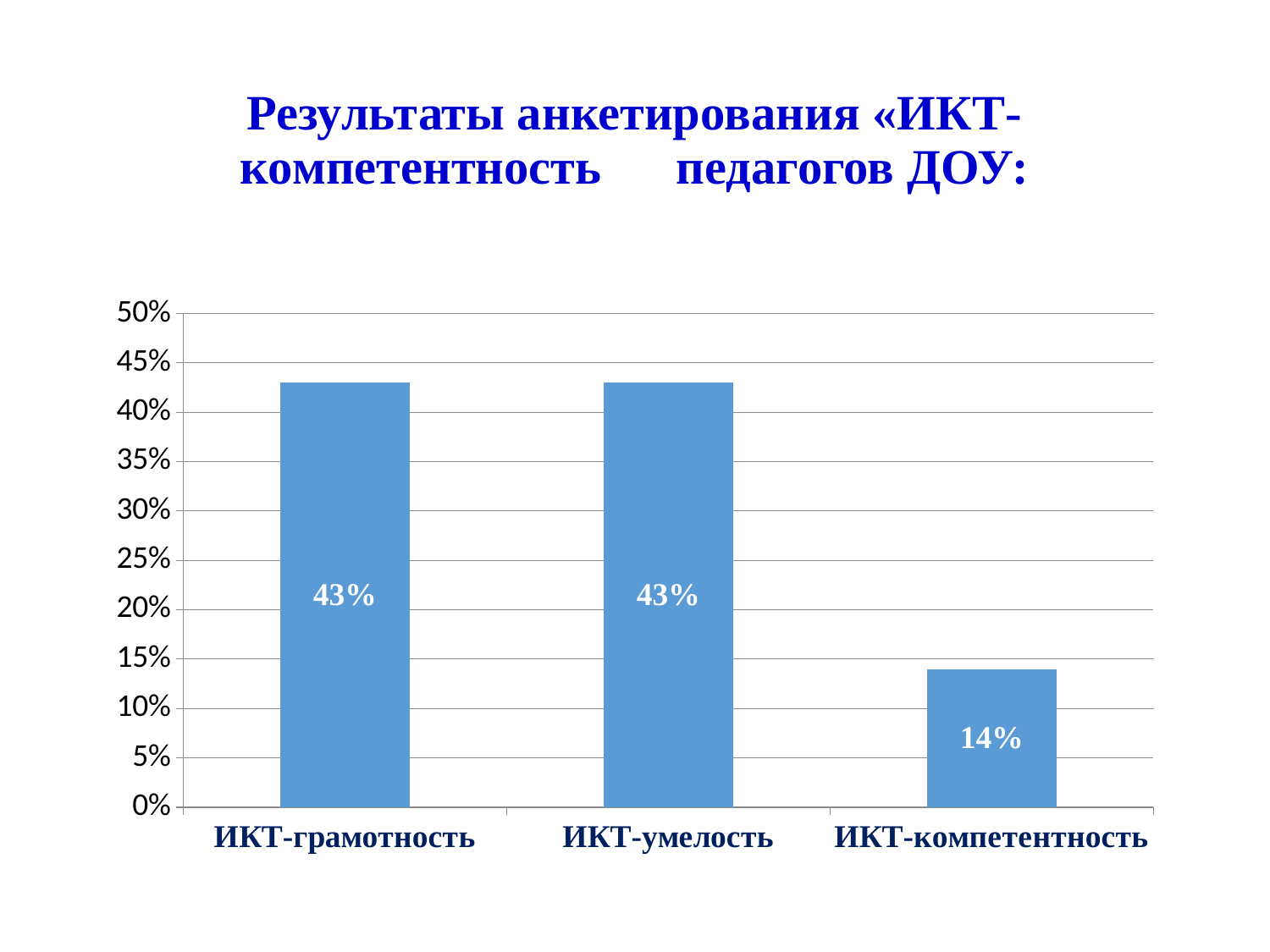
What is the value for ИКТ-умелость? 43% What is the difference between the values for ИКТ-грамотность and ИКТ-компетентность? 29% Is the value for ИКТ-грамотность greater or less than 40%? greater What colour are the bars in the chart? blue Which is larger, the value for ИКТ-умелость or the value for ИКТ-компетентность? ИКТ-умелость What is the value for ИКТ-грамотность? 43% How many categories are shown on the chart? 3 What is the highest value shown on the vertical axis? 50% What kind of chart is shown on the slide? bar chart Is the value for ИКТ-компетентность greater or less than 20%? less Which category has the lowest value? ИКТ-компетентность What is the value for ИКТ-компетентность? 14%